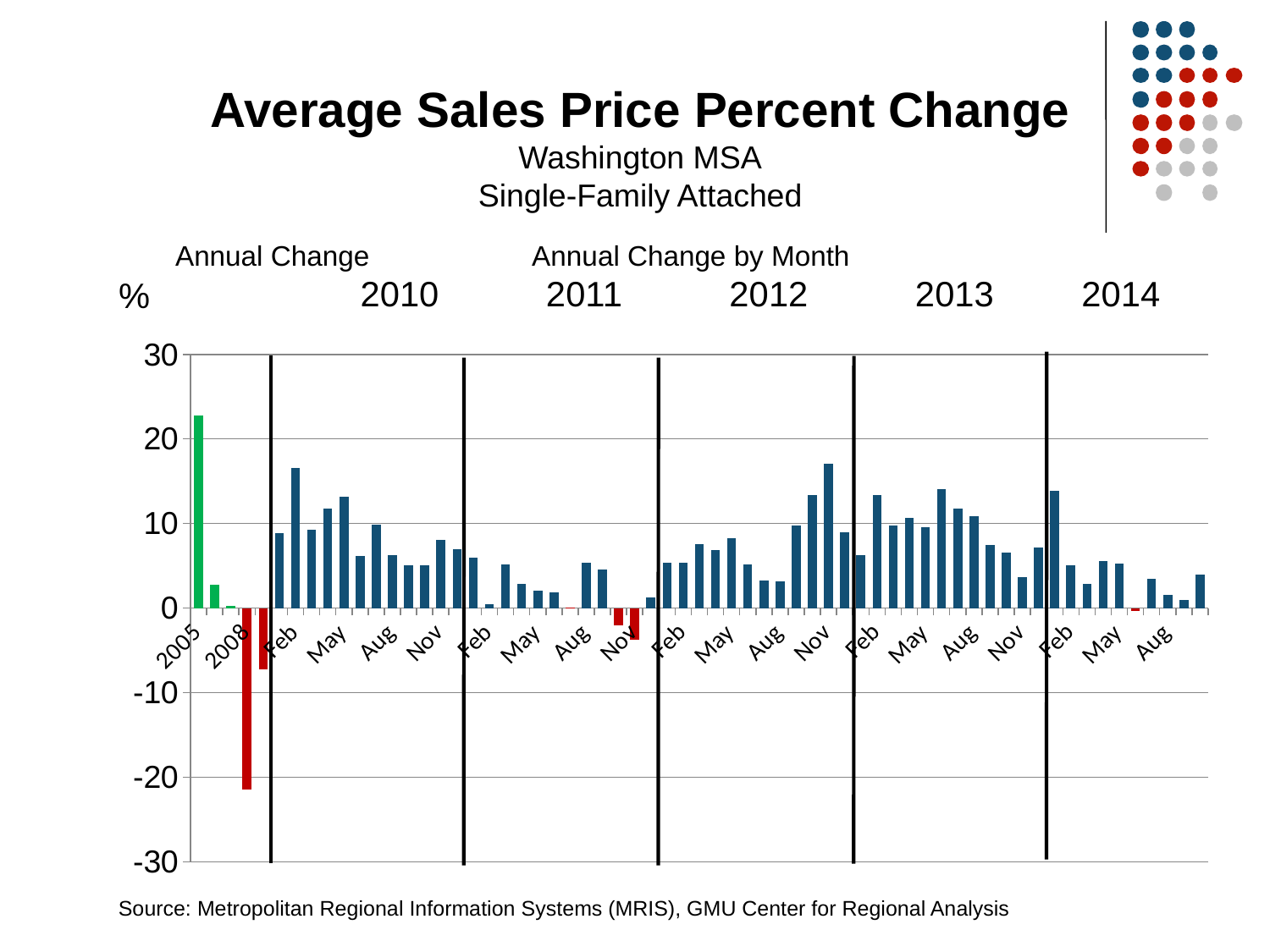
What kind of chart is shown on the slide? bar chart What is the title of the chart? Average Sales Price Percent Change Do the monthly values in 2012 generally rise or fall from Feb to Nov? rise Which annual change bar is the highest: 2005 or 2008? 2005 Which is larger, the monthly value for Nov 2012 or for Aug 2012? Nov 2012 How many years are labelled in the Annual Change by Month section of the chart? 5 Is the annual change by month value for Aug 2012 greater or less than 10? less Is the annual change value for 2008 greater or less than -10? less Is the annual change by month value for Nov 2012 greater or less than 10? greater Which housing type does the chart cover, according to the subtitle? Single-Family Attached